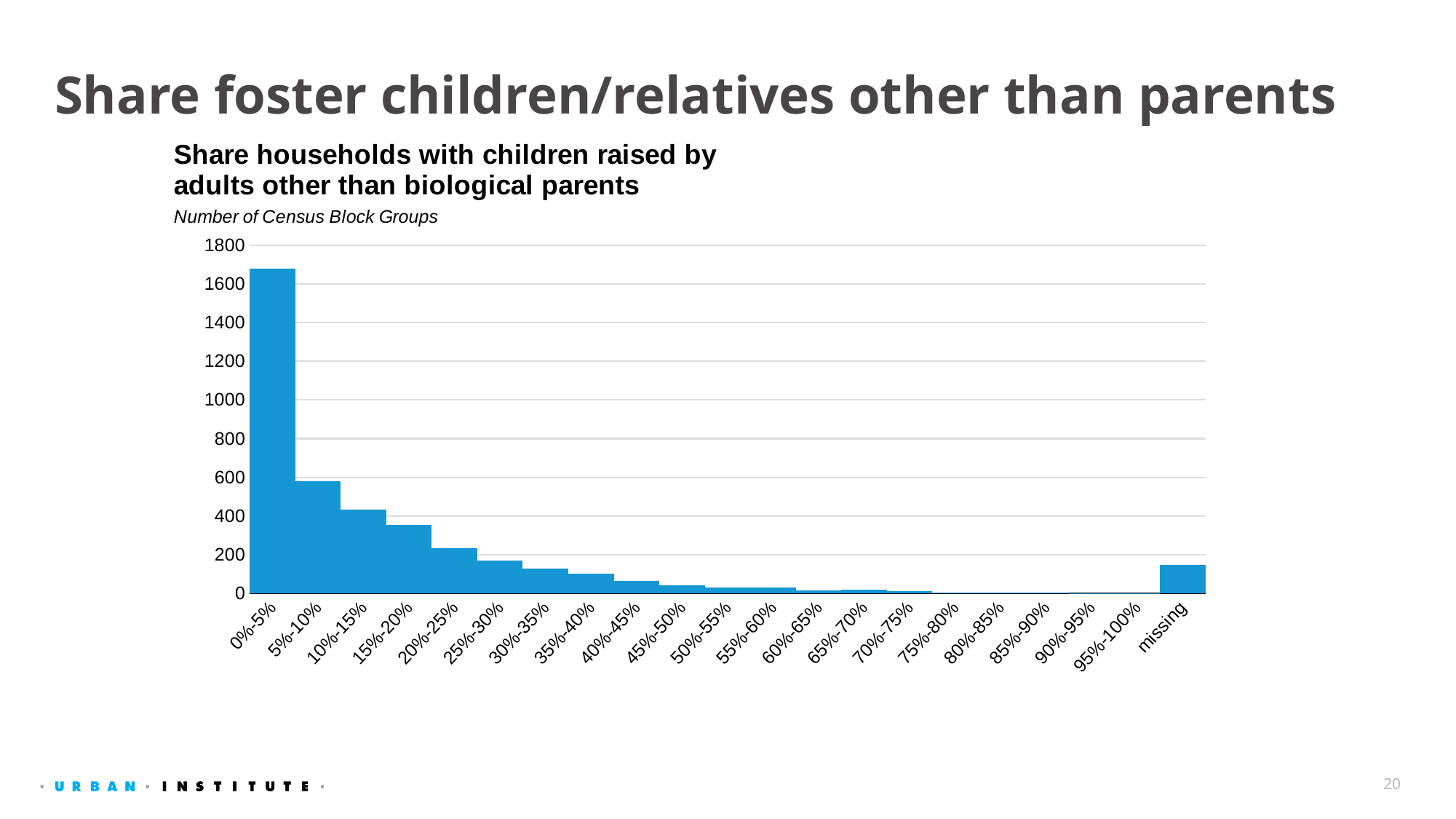
Do the values rise or fall moving from 0%-5% toward 95%-100% along the x axis? fall What kind of chart is shown on the slide? bar chart How many categories are shown on the x axis? 21 Which is larger, the value for 0%-5% or the value for 5%-10%? 0%-5% Which is larger, the value for missing or the value for 35%-40%? missing Is the value for 0%-5% greater or less than 1600? greater What does the y axis of the chart measure, according to the label above it? Number of Census Block Groups Is the value for 15%-20% greater or less than 400? less Which category has the highest number of census block groups? 0%-5% Is the value for 20%-25% greater or less than 200? greater